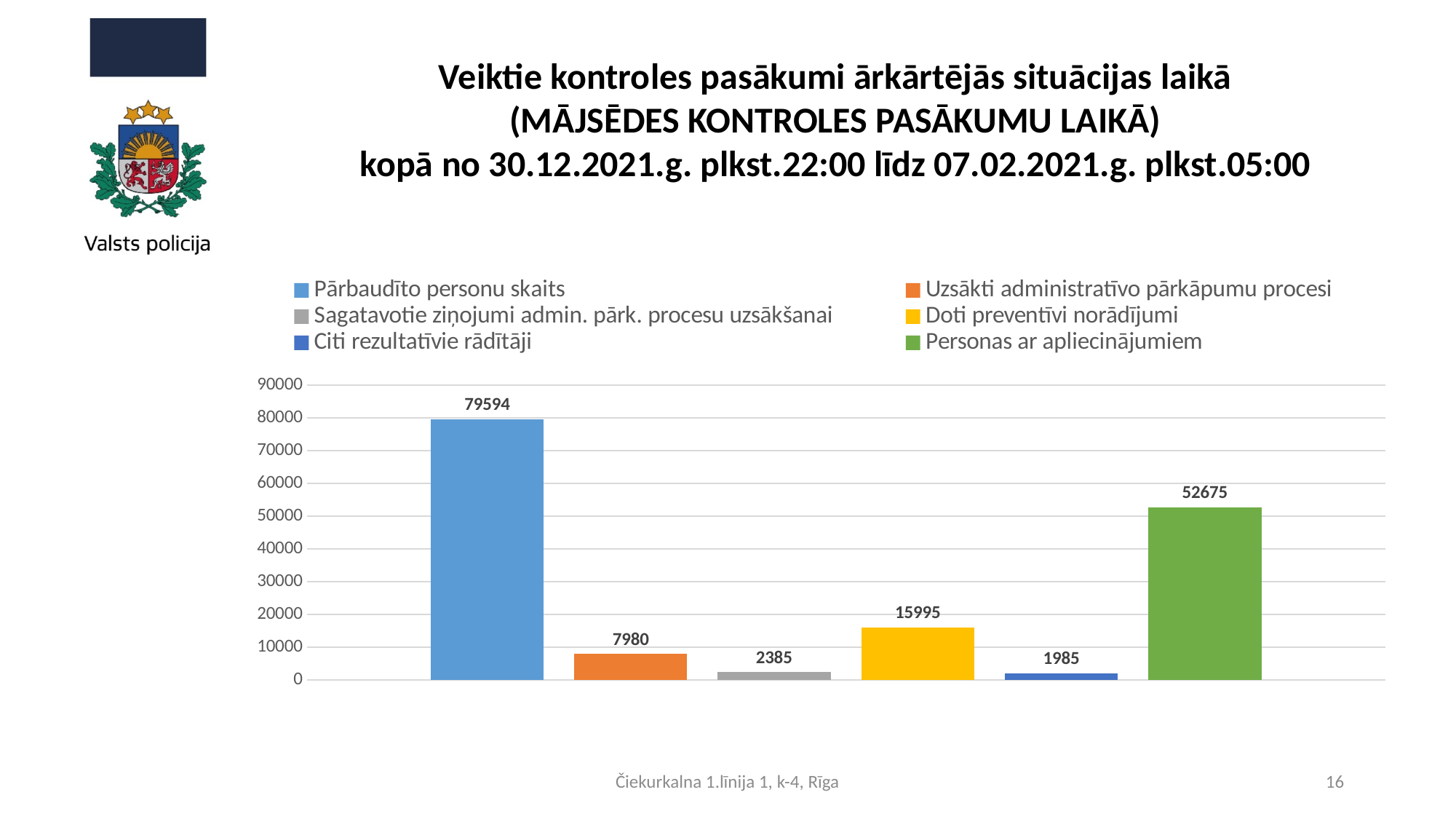
What is the value for Sagatavotie ziņojumi admin. pārk. procesu uzsākšanai? 2385 What colour is the bar for Doti preventīvi norādījumi? Yellow What is the value for Personas ar apliecinājumiem? 52675 How many series does the legend list? 6 Which is larger, Doti preventīvi norādījumi or Uzsākti administratīvo pārkāpumu procesi? Doti preventīvi norādījumi What is the value for Doti preventīvi norādījumi? 15995 Which series has the lowest value? Citi rezultatīvie rādītāji Which series has the highest value? Pārbaudīto personu skaits What is the value for Pārbaudīto personu skaits? 79594 What is the difference between Pārbaudīto personu skaits and Personas ar apliecinājumiem? 26919 What is the value for Uzsākti administratīvo pārkāpumu procesi? 7980 What kind of chart is shown on the slide? Bar chart